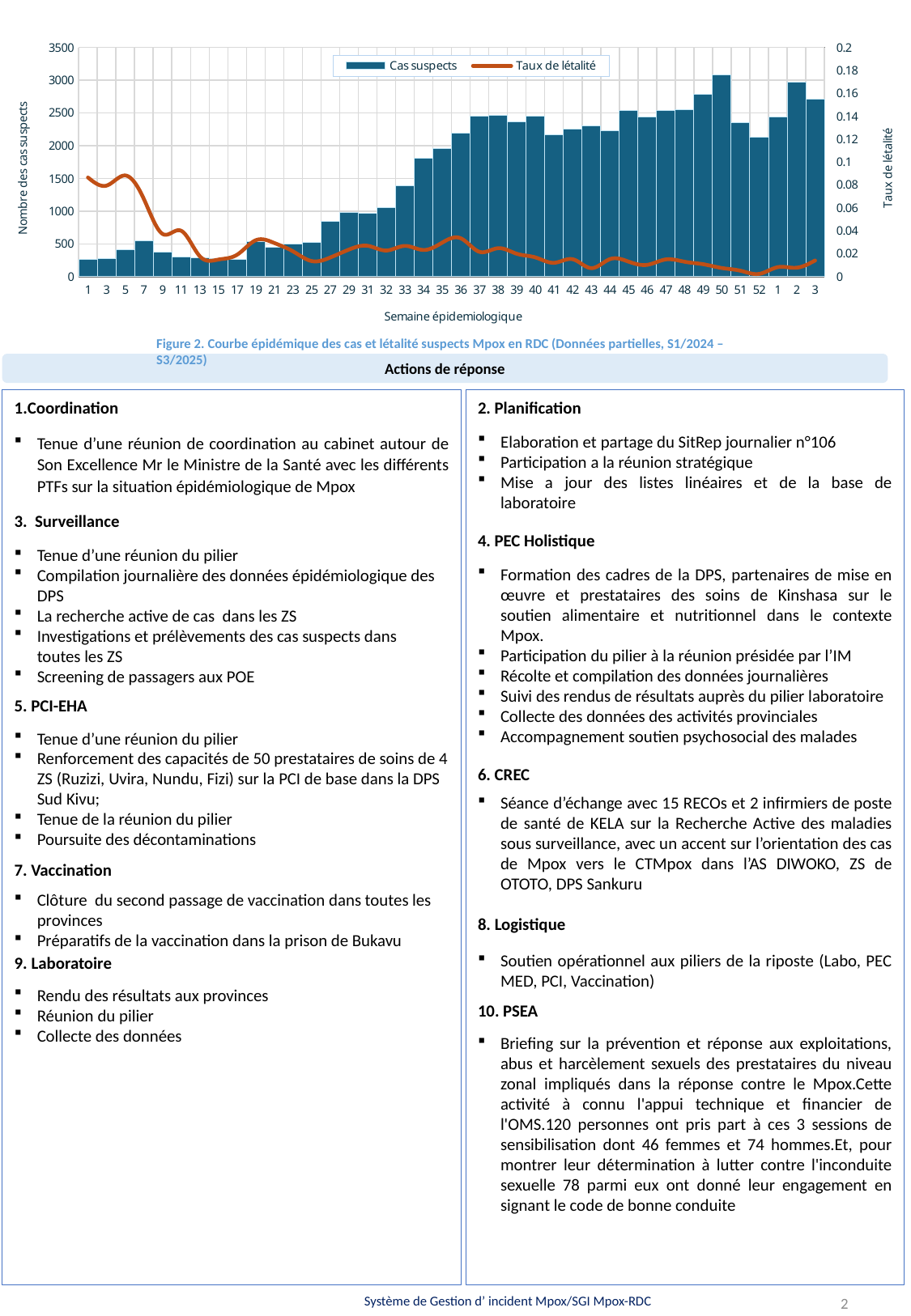
Which series is plotted as bars in the chart? Cas suspects Is the number of suspected cases in week 33 greater or less than 1000? greater Which has more suspected cases, week 50 or week 52? Week 50 Is the number of suspected cases in week 50 greater or less than 2500? greater How many series does the chart legend list? 2 Is the number of suspected cases in week 34 greater or less than 2000? less Which has more suspected cases, week 36 or week 37? Week 37 What is the title of the x axis of the chart? Semaine épidemiologique Which epidemiological week has the highest bar of suspected cases? 50 Does the case fatality rate (Taux de létalité) generally rise or fall from week 1 of 2024 to week 3 of 2025? Fall What kind of chart is shown on the slide? A combined bar and line chart